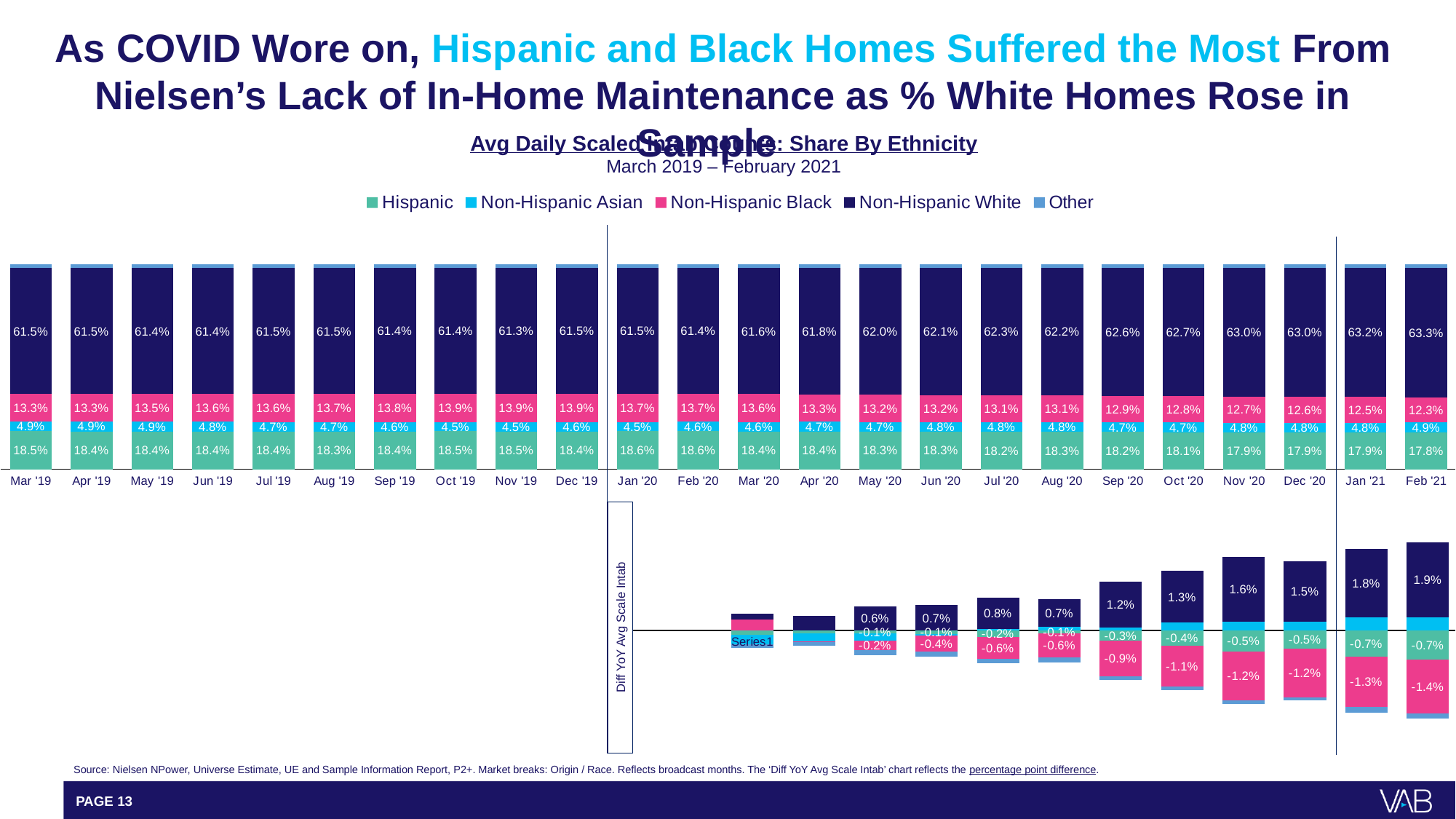
In the top stacked bar chart, which month has the lowest Non-Hispanic Black share? Feb '21 In the top stacked bar chart, what is the Non-Hispanic Black share for Oct '19? 13.9% In the top stacked bar chart, does the Non-Hispanic White share rise or fall from Jan '20 to Feb '21? Rise In the top stacked bar chart, is the Hispanic share larger in Mar '19 or in Feb '21? Mar '19 In the top stacked bar chart, what is the Non-Hispanic White share for Feb '21? 63.3% In the bottom 'Diff YoY Avg Scale Intab' chart, what is the largest Non-Hispanic White value shown? 1.9% What kind of chart is the top chart on the slide? Stacked bar chart How many months are shown on the x axis of the top stacked bar chart? 24 In the top stacked bar chart, which month has the highest Non-Hispanic White share? Feb '21 In the top stacked bar chart, what is the Hispanic share for Mar '19? 18.5% In the top stacked bar chart, by how many percentage points did the Non-Hispanic White share in Feb '21 exceed that in Mar '19? 1.8 percentage points How many series does the legend of the top chart list? 5